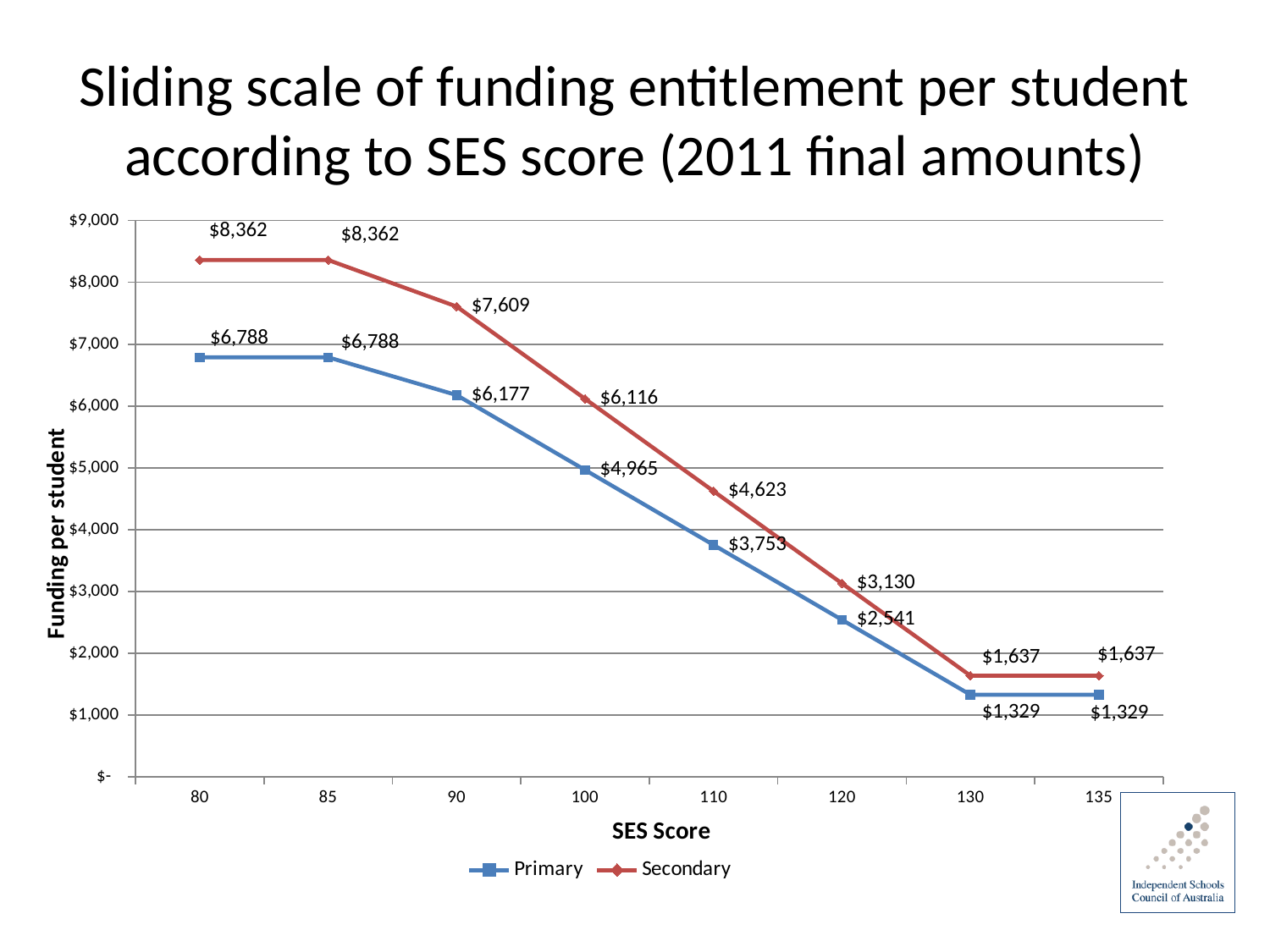
At which SES score is the Primary funding per student lowest? 130 and 135 What is the Secondary funding per student at SES score 120? $3,130 Does the Primary funding per student rise or fall as the SES score increases from 85 to 130? Fall How many SES score points are plotted on the x axis? 8 What is the title of the x axis? SES Score What is the Secondary funding per student at SES score 90? $7,609 How many series does the legend list? 2 What is the highest Secondary funding per student shown? $8,362 Which series has the higher funding per student at SES score 130, Primary or Secondary? Secondary What is the Primary funding per student at SES score 110? $3,753 What type of chart is shown on the slide? Line chart What is the difference between Secondary and Primary funding per student at SES score 100? $1,151